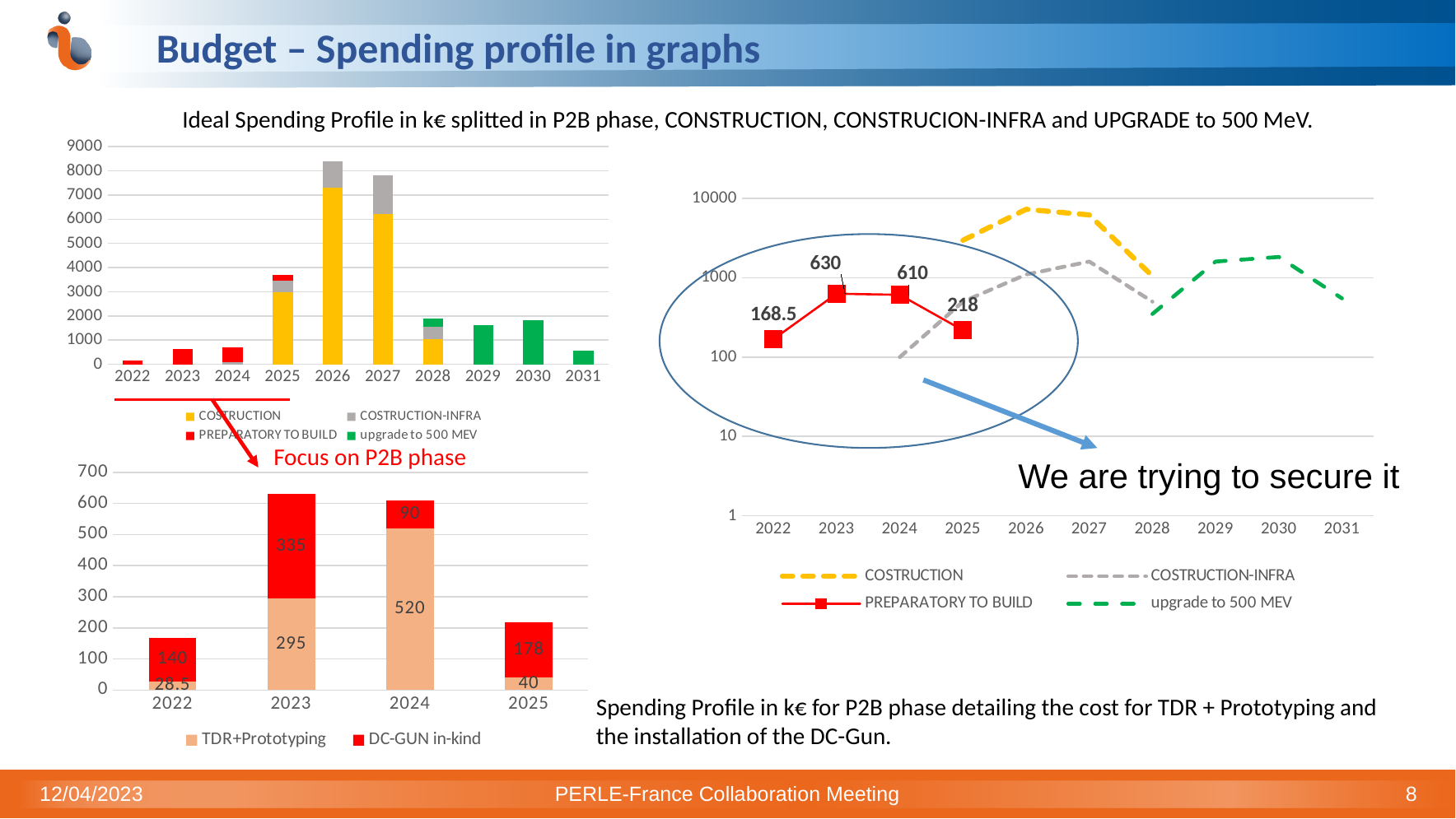
In the top-left 'Ideal Spending Profile' chart, is the total bar for 2026 greater or less than 8000? greater In the bottom-left 'Focus on P2B phase' chart, what is the DC-GUN in-kind value for 2023? 335 In the bottom-left 'Focus on P2B phase' chart, how many years are shown on the x axis? 4 In the bottom-left 'Focus on P2B phase' chart, what is the TDR+Prototyping value for 2024? 520 In the bottom-left 'Focus on P2B phase' chart, what is the difference between the TDR+Prototyping values for 2024 and 2023? 225 In the bottom-left 'Focus on P2B phase' chart, which is larger for 2022: TDR+Prototyping or DC-GUN in-kind? DC-GUN in-kind What kind of chart is the right-hand chart with the dashed lines? Line chart In the bottom-left 'Focus on P2B phase' chart, what is the total of the stacked bar for 2023? 630 In the bottom-left 'Focus on P2B phase' chart, which year has the highest DC-GUN in-kind value? 2023 In the top-left 'Ideal Spending Profile' chart, which year has the tallest stacked bar? 2026 How many series does the legend of the right-hand chart list? 4 In the right-hand line chart, what is the PREPARATORY TO BUILD value for 2025? 218